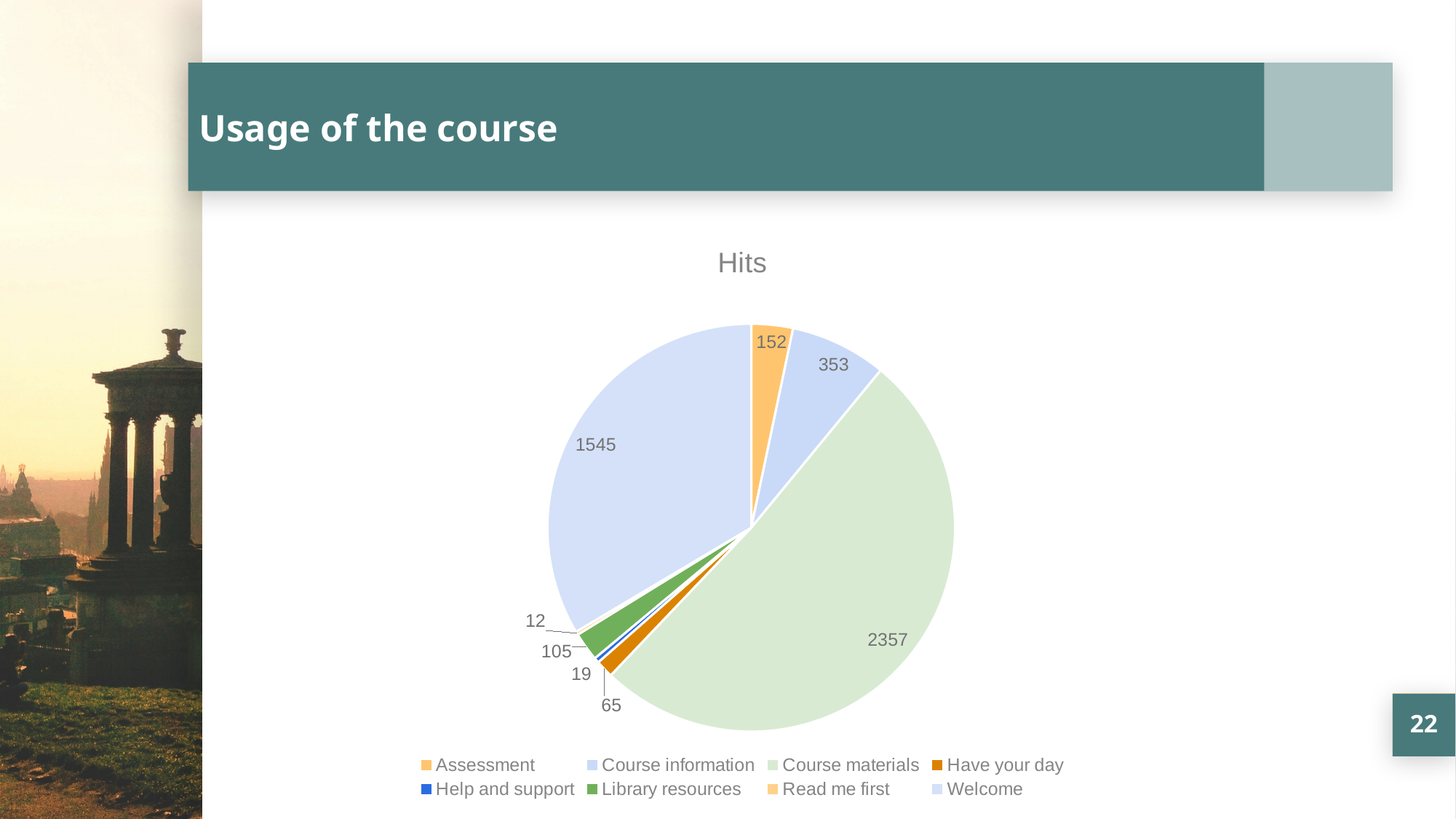
Which is larger, Course information or Assessment? Course information Which category has the smallest slice? Read me first What is the value for Course materials? 2357 What is the value for Welcome? 1545 What is the title of the chart? Hits How many categories does the legend list? 8 Which category has the largest slice? Course materials What is the value for Library resources? 105 What is the value for Assessment? 152 What kind of chart is shown on the slide? pie chart What is the difference between Course materials and Welcome? 812 What is the total of all slices in the pie? 4608